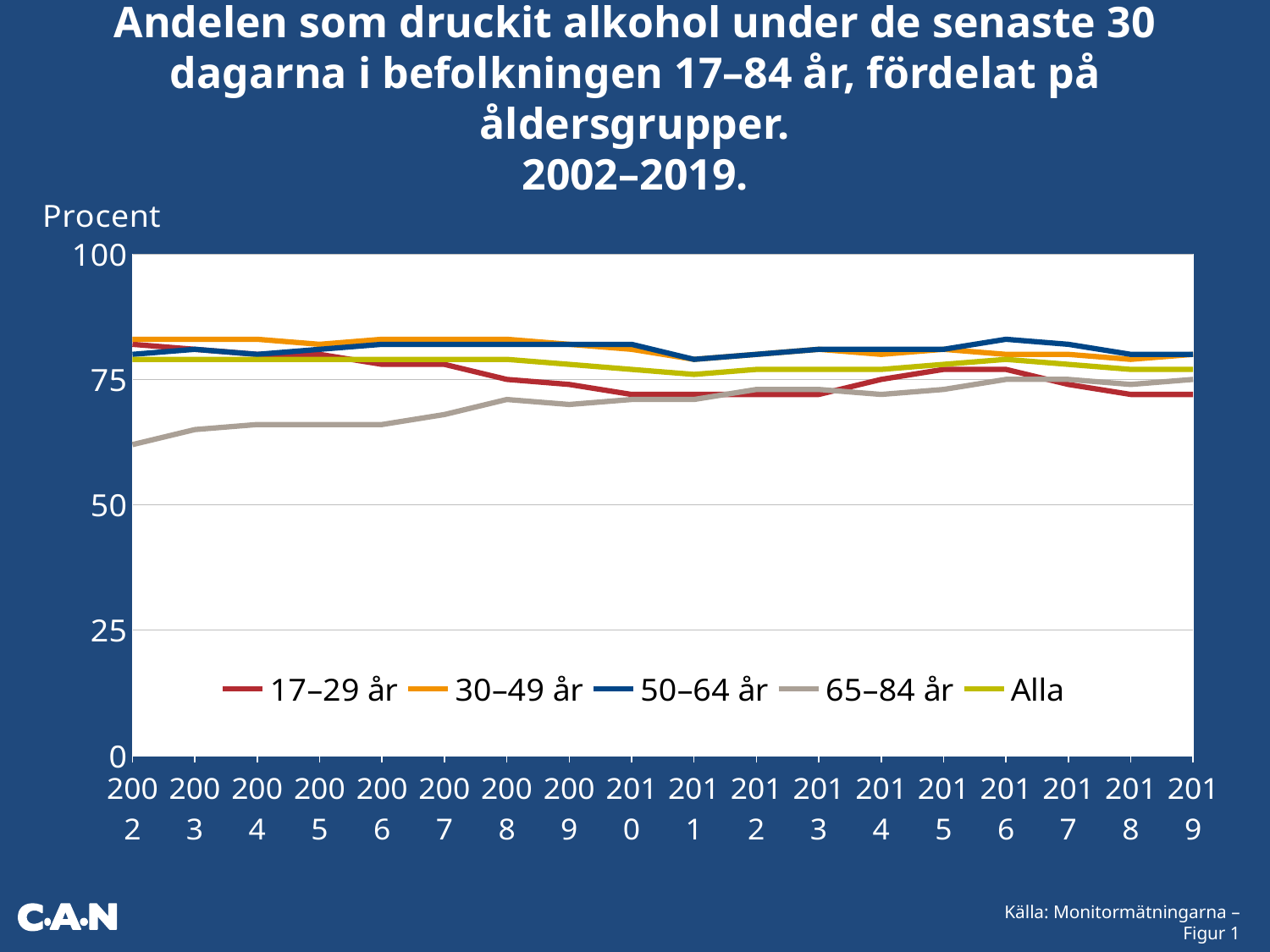
Is the value for 65–84 år in 2002 greater or less than 75? less What kind of chart is shown on the slide? line chart What label is shown on the y axis of the chart? Procent Is the value for 17–29 år in 2019 greater or less than 75? less Which is larger in 2002, the value for 65–84 år or the value for 50–64 år? 50–64 år How many series does the legend list? 5 Does the line for 65–84 år generally rise or fall from 2002 to 2019? rise How many years are plotted along the x axis? 18 Does the line for 17–29 år generally rise or fall from 2002 to 2019? fall Which age group has the lowest value in 2002? 65–84 år Is the value for 50–64 år in 2002 greater or less than 75? greater